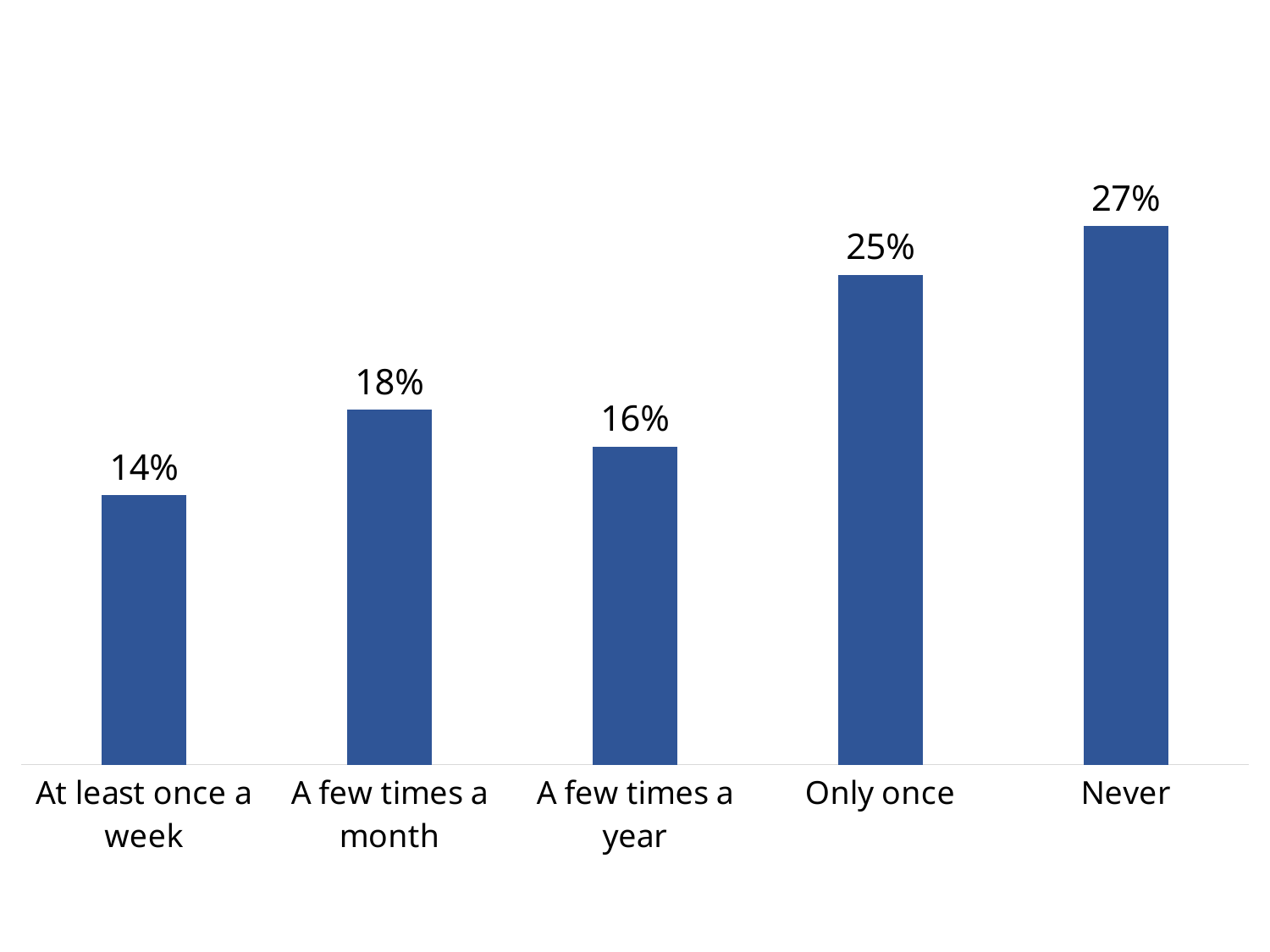
What is the value for "Never"? 27% What is the value for "A few times a month"? 18% What is the difference between the values for "Never" and "At least once a week"? 13% Which is larger, the value for "Only once" or the value for "A few times a month"? Only once What is the value for "At least once a week"? 14% What kind of chart is shown on the slide? Bar chart What is the value for "Only once"? 25% Which category has the lowest value? At least once a week What is the value for "A few times a year"? 16% What is the difference between the values for "A few times a month" and "A few times a year"? 2% Which category has the highest value? Never How many categories are shown in the chart? 5